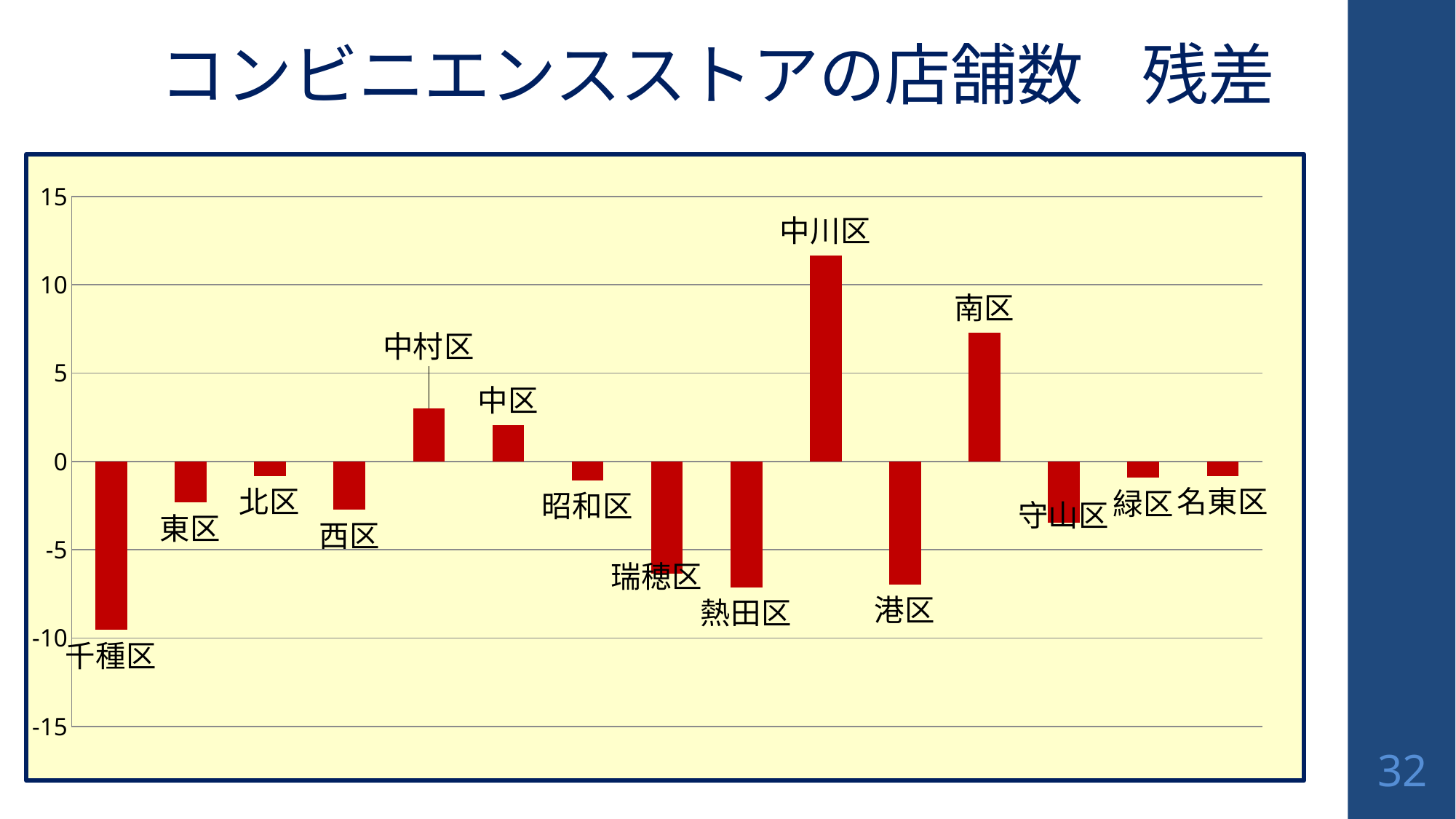
Is the value for 中川区 greater or less than 10? greater What is the title of the slide containing the chart? コンビニエンスストアの店舗数 残差 Is the value for 中村区 greater or less than 5? less Which has the larger value, 中川区 or 南区? 中川区 Which ward has the highest value in the chart? 中川区 Which has the larger value, 中村区 or 中区? 中村区 Is the value for 南区 greater or less than 5? greater What kind of chart is shown on the slide? bar chart Which ward has the lowest value in the chart? 千種区 How many wards (categories) are plotted in the chart? 15